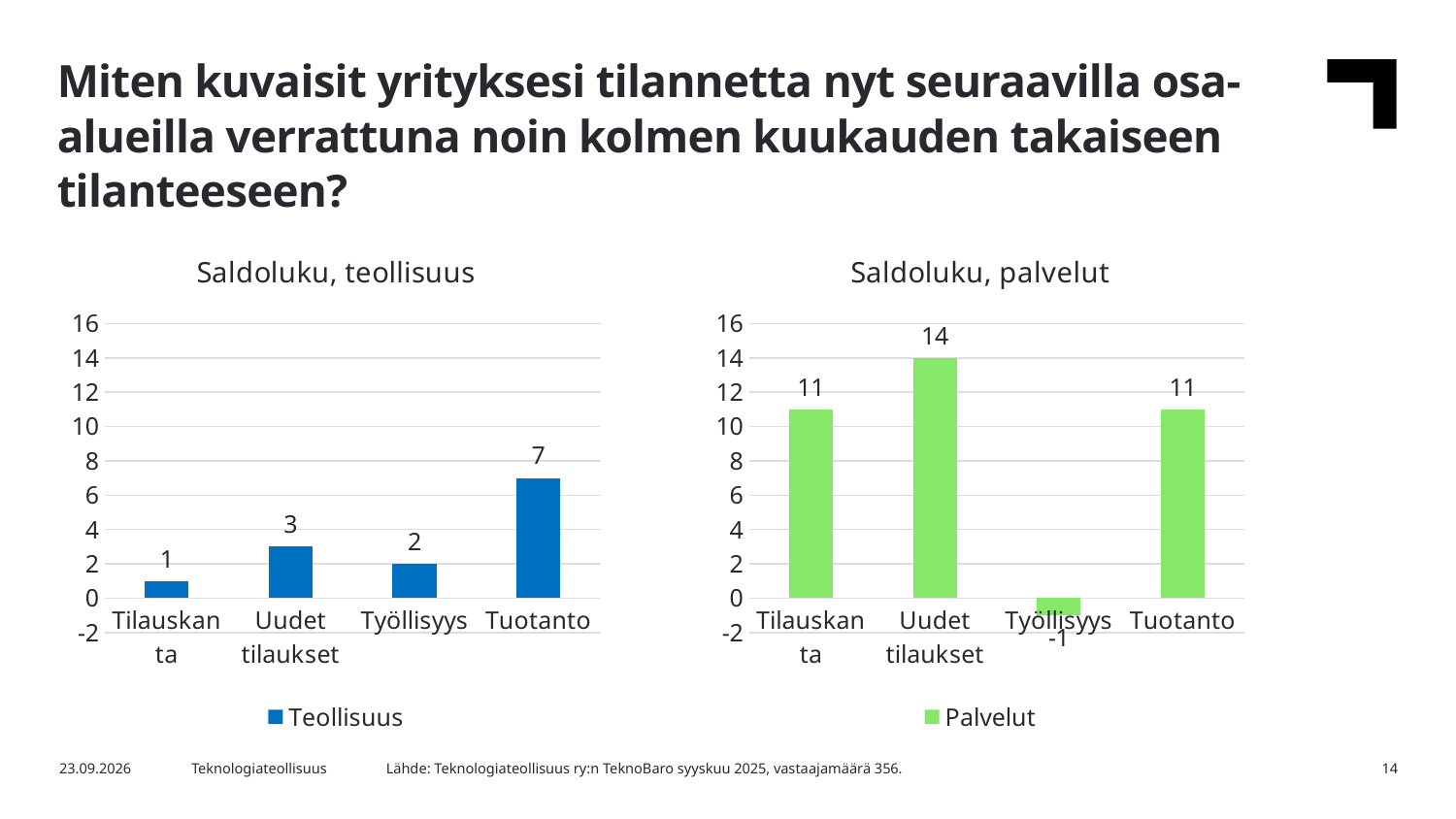
In the 'Saldoluku, palvelut' chart, what is the value for Työllisyys? -1 Which is larger: Tuotanto in the 'Saldoluku, teollisuus' chart or Tuotanto in the 'Saldoluku, palvelut' chart? Saldoluku, palvelut What series does the legend of the 'Saldoluku, palvelut' chart list? Palvelut In the 'Saldoluku, teollisuus' chart, what is the difference between Tuotanto and Uudet tilaukset? 4 In the 'Saldoluku, teollisuus' chart, which category has the highest value? Tuotanto In the 'Saldoluku, teollisuus' chart, which category has the lowest value? Tilauskanta In the 'Saldoluku, palvelut' chart, which category has the lowest value? Työllisyys In the 'Saldoluku, teollisuus' chart, what is the value for Tuotanto? 7 In the 'Saldoluku, palvelut' chart, what is the value for Uudet tilaukset? 14 In the 'Saldoluku, palvelut' chart, what is the difference between Uudet tilaukset and Tilauskanta? 3 How many categories are shown in the 'Saldoluku, palvelut' chart? 4 What type of chart is 'Saldoluku, teollisuus'? Bar chart